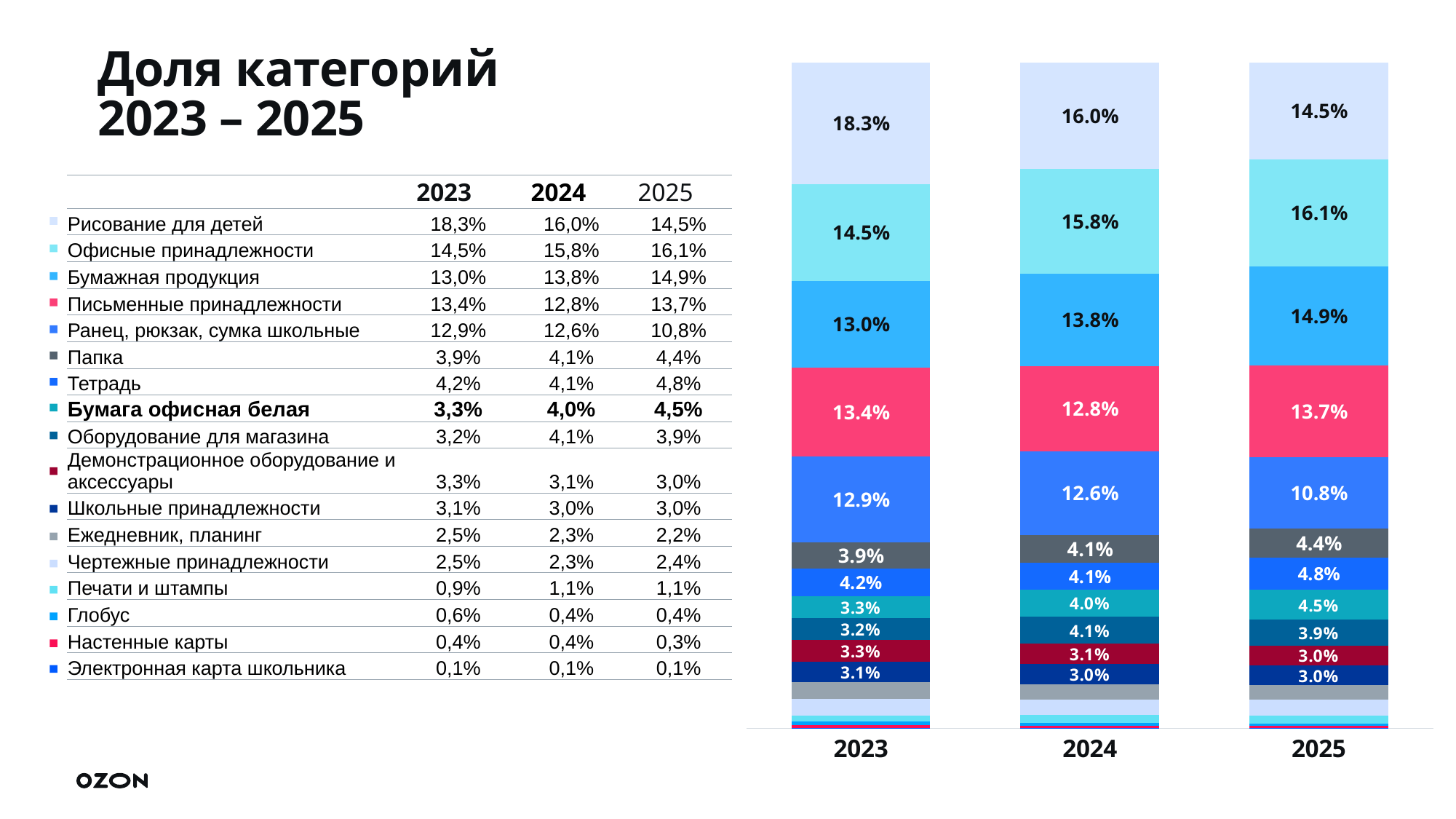
What is the share of Бумажная продукция in the 2024 bar? 13.8% Which year has the highest share for Рисование для детей? 2023 What is the share of Офисные принадлежности in the 2025 bar? 16.1% Which year has the lowest share for Ранец, рюкзак, сумка школьные? 2025 Is the share of Письменные принадлежности larger in 2023 or in 2024? 2023 How many bars (years) does the chart show? 3 By how many percentage points did the share of Рисование для детей change from 2023 to 2025? 3.8 percentage points What is the share of the top segment (Рисование для детей) in the 2023 bar? 18.3% What is the share of Ранец, рюкзак, сумка школьные in the 2025 bar? 10.8% What is the title of the slide? Доля категорий 2023 – 2025 Does the share of Бумажная продукция rise or fall from 2023 to 2025? rise What kind of chart is shown on the slide? stacked bar chart